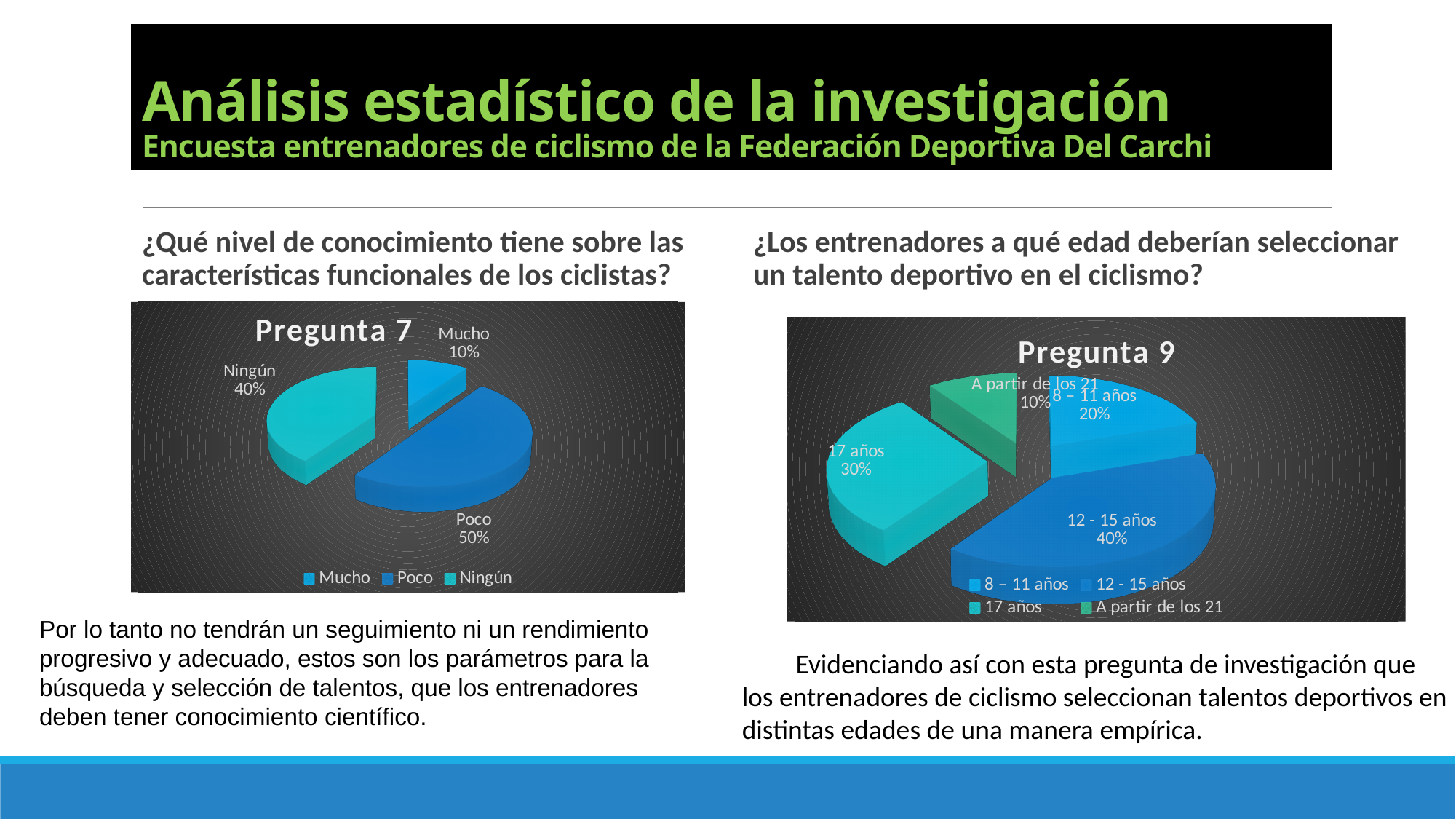
In the 'Pregunta 9' chart, which category has the smallest share? A partir de los 21 In the 'Pregunta 7' chart, how many categories does the legend list? 3 In the 'Pregunta 7' chart, which category has the smallest share? Mucho In the 'Pregunta 7' chart, which category has the largest share? Poco In the 'Pregunta 9' chart, what share does '12 - 15 años' have? 40% In the 'Pregunta 7' chart, what is the difference between the shares of 'Poco' and 'Mucho'? 40% What kind of chart is 'Pregunta 7'? Pie chart In the 'Pregunta 7' chart, what share does 'Ningún' have? 40% In the 'Pregunta 9' chart, what share does '17 años' have? 30% In the 'Pregunta 9' chart, which is larger: '8 – 11 años' or '17 años'? 17 años In the 'Pregunta 9' chart, how many categories does the legend list? 4 In the 'Pregunta 7' chart, what share does 'Poco' have? 50%